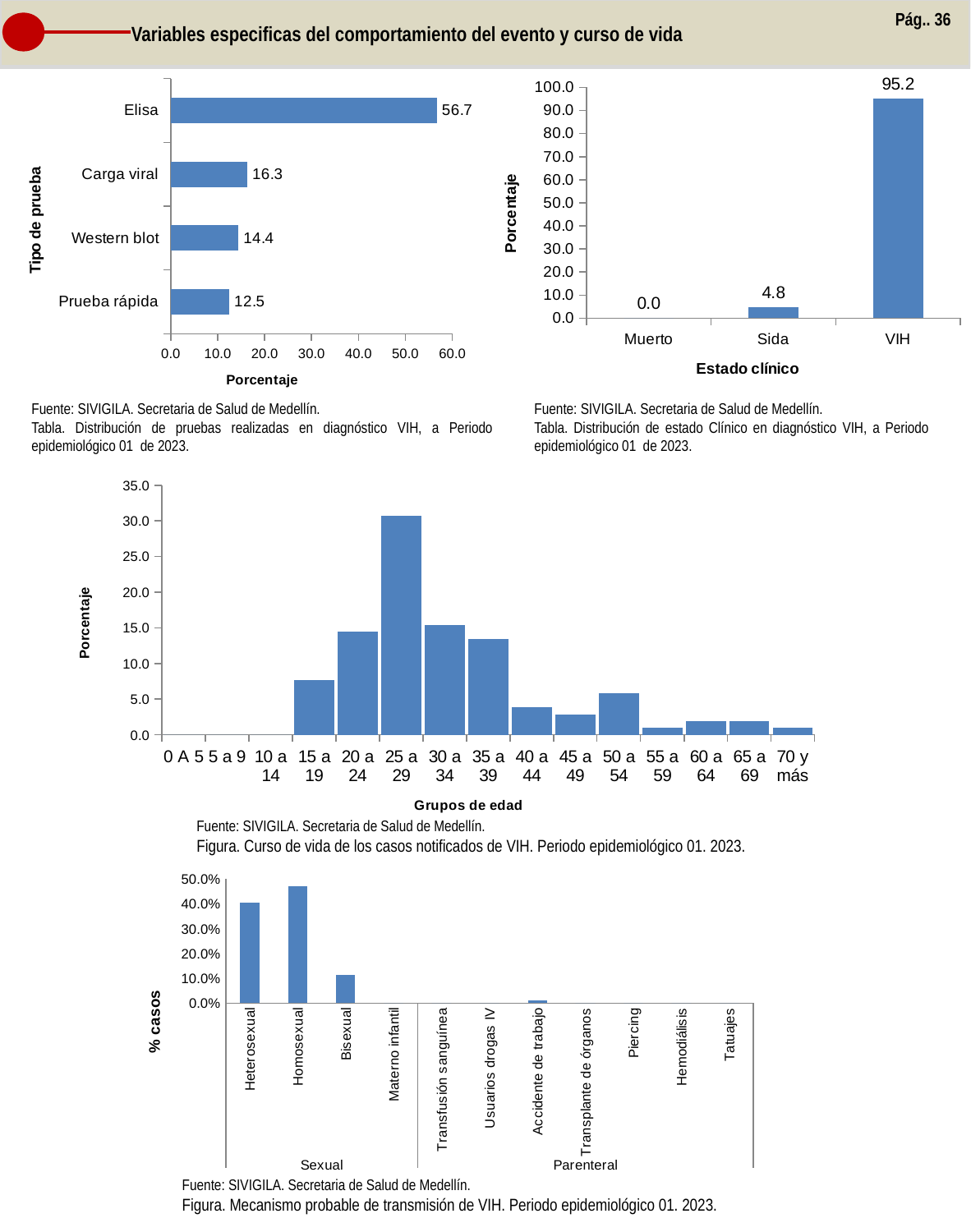
In the top-right chart (Estado clínico), which clinical state has the highest percentage? VIH In the top-left chart (Tipo de prueba), how many types of test are shown? 4 In the top-right chart (Estado clínico), what is the percentage for Sida? 4.8 In the middle chart (Grupos de edad), is the value for 35 a 39 greater or less than 10.0? greater In the top-left chart (Tipo de prueba), which type of test has the lowest percentage? Prueba rápida In the bottom chart (Mecanismo probable de transmisión), which is larger, the value for Homosexual or for Heterosexual? Homosexual In the middle chart (Grupos de edad), is the value for 15 a 19 greater or less than 10.0? less What kind of chart is the top-left chart (Tipo de prueba)? Bar chart In the top-left chart (Tipo de prueba), what is the percentage for Elisa? 56.7 In the top-right chart (Estado clínico), what is the difference between the percentages for VIH and Sida? 90.4 In the top-left chart (Tipo de prueba), what is the difference between the percentages for Carga viral and Western blot? 1.9 In the middle chart (Grupos de edad), which age group has the highest percentage? 25 a 29